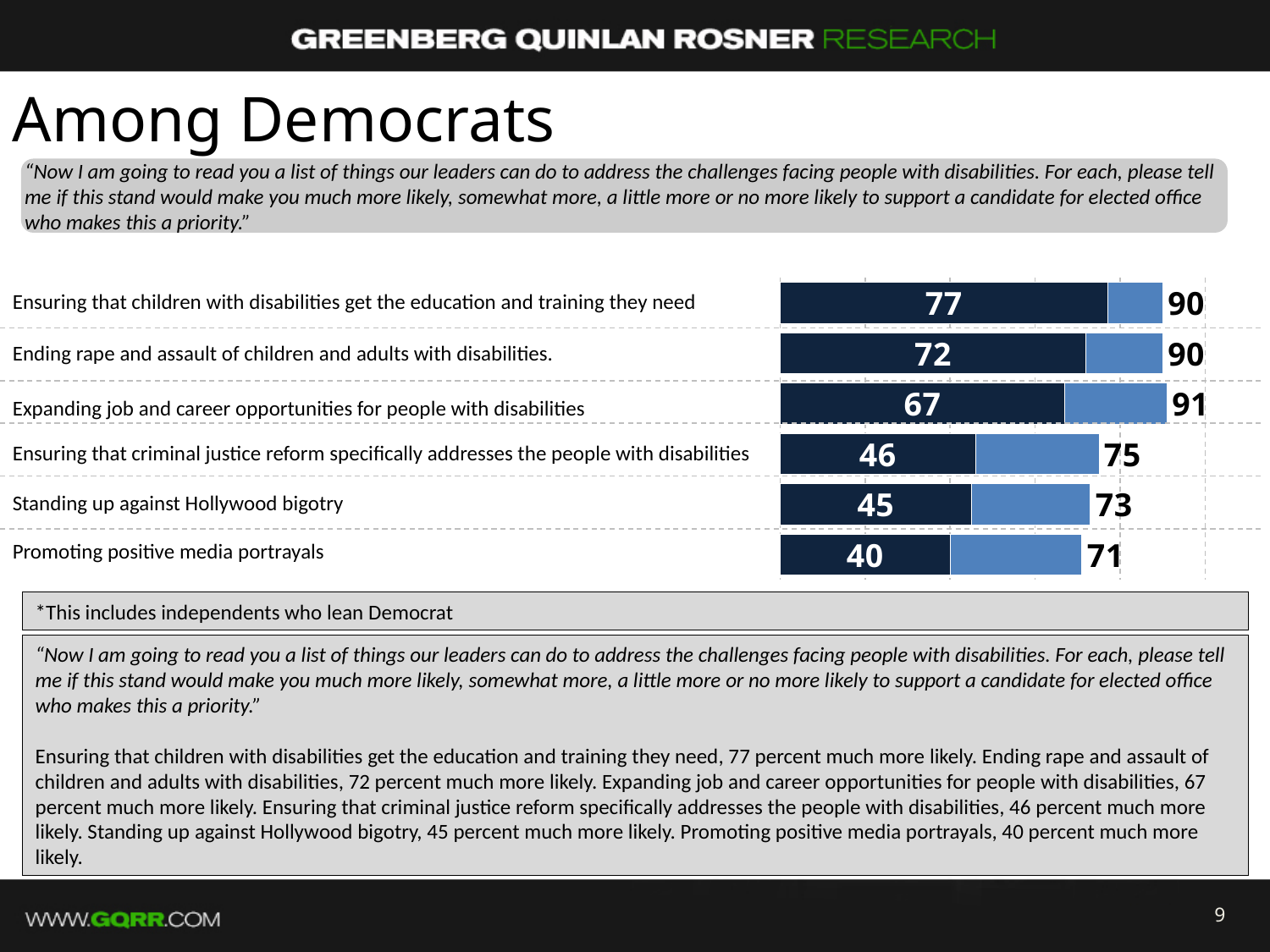
What kind of chart is shown on the slide? Stacked bar chart Which category has the highest dark blue ('much more likely') value? Ensuring that children with disabilities get the education and training they need Which has a larger total value: 'Ensuring that criminal justice reform specifically addresses the people with disabilities' or 'Standing up against Hollywood bigotry'? Ensuring that criminal justice reform specifically addresses the people with disabilities Which category has the lowest total value? Promoting positive media portrayals How many categories are shown in the chart? 6 Do the dark blue values rise or fall going from the top category to the bottom category? Fall What is the total value shown at the end of the bar for 'Expanding job and career opportunities for people with disabilities'? 91 What is the dark blue segment value for 'Standing up against Hollywood bigotry'? 45 What is the difference between the dark blue values for 'Ending rape and assault of children and adults with disabilities.' and 'Ensuring that criminal justice reform specifically addresses the people with disabilities'? 26 What is the 'much more likely' value (dark blue segment) for 'Ensuring that children with disabilities get the education and training they need'? 77 What is the total value shown for 'Promoting positive media portrayals'? 71 What is the difference between the total value and the dark blue value for 'Ensuring that children with disabilities get the education and training they need'? 13